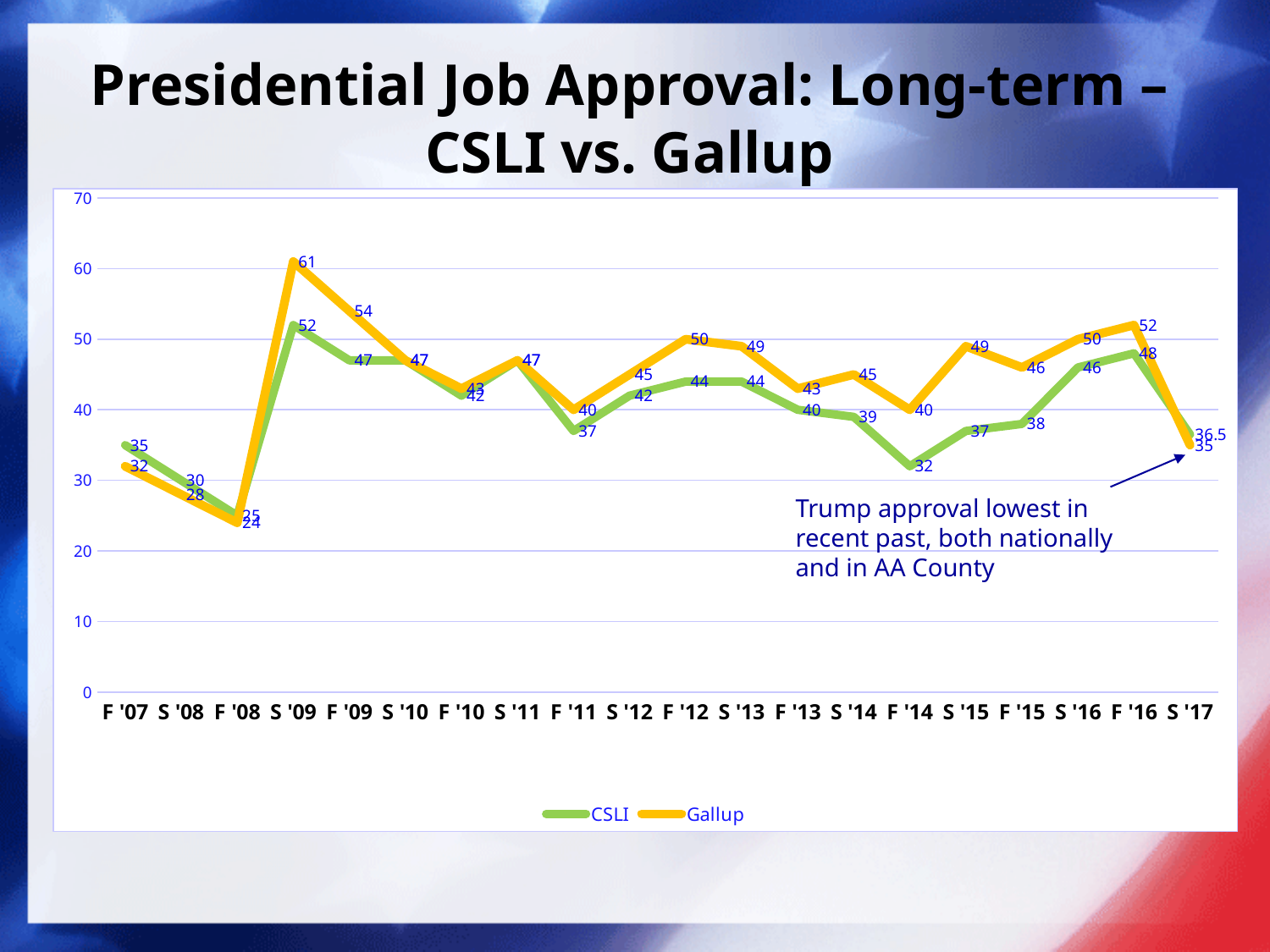
By how much did the Gallup value rise from F '08 to S '09? 37 What is the Gallup value for S '09? 61 At which time point is the Gallup series lowest? F '08 What is the CSLI value for F '14? 32 How many time points are shown along the x axis? 20 What is the CSLI value for S '17? 36.5 How many series does the legend list? 2 Which colour represents the Gallup series? yellow At which time point is the Gallup series highest? S '09 What is the difference between the Gallup and CSLI values at S '15? 12 At F '16, which series has the higher value, CSLI or Gallup? Gallup What kind of chart is shown on the slide? line chart